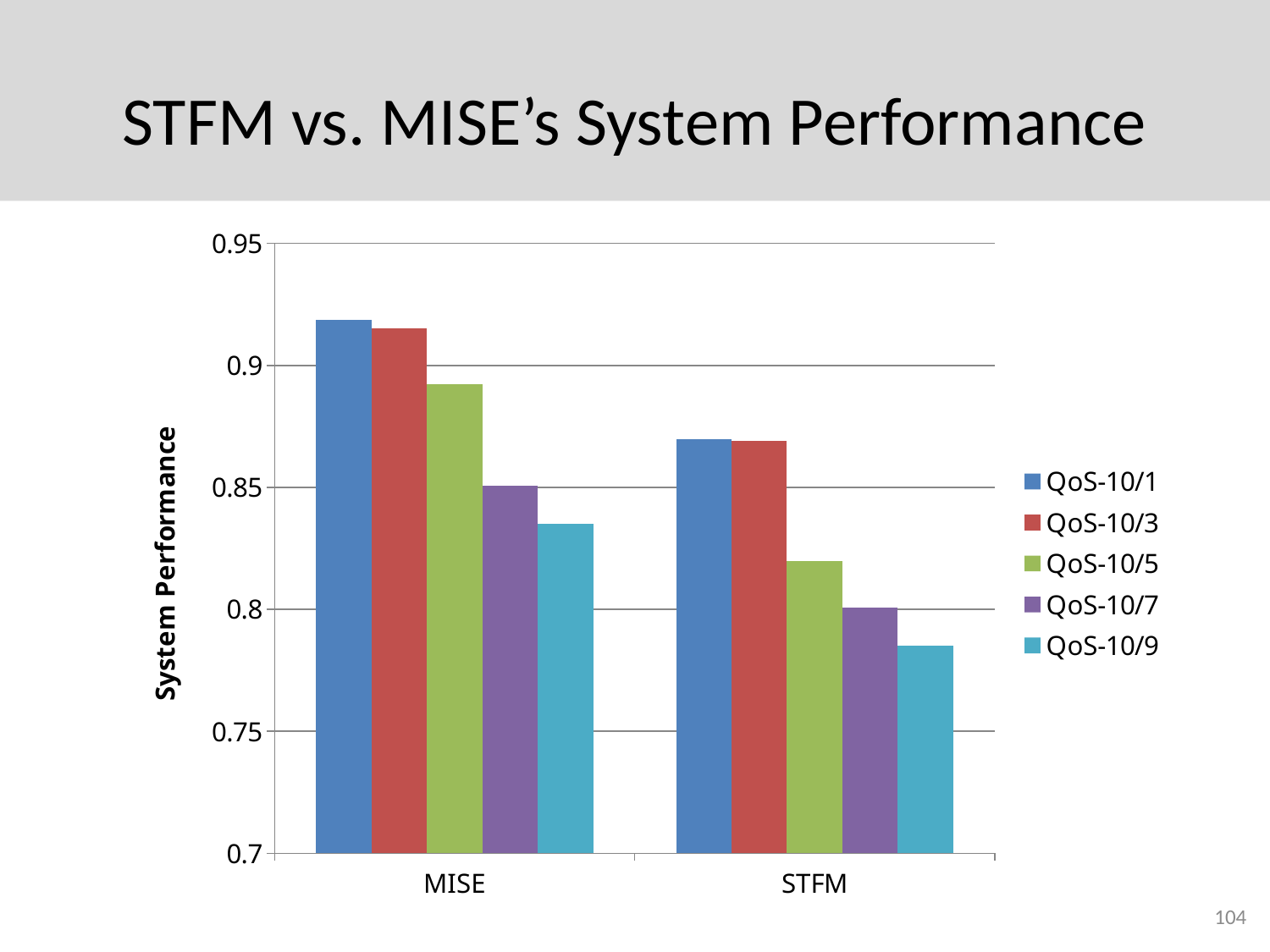
Is the value for QoS-10/1 under STFM greater or less than 0.85? greater What is the label on the vertical axis? System Performance Within the MISE group, do the values rise or fall going from QoS-10/1 to QoS-10/9? fall Which has the larger QoS-10/5 value, MISE or STFM? MISE Is the value for QoS-10/9 under STFM greater or less than 0.8? less Is the value for QoS-10/9 under MISE greater or less than 0.85? less Which series has the lowest value within the STFM group? QoS-10/9 How many categories are shown on the x axis? 2 How many series does the legend list? 5 What kind of chart is shown on the slide? bar chart